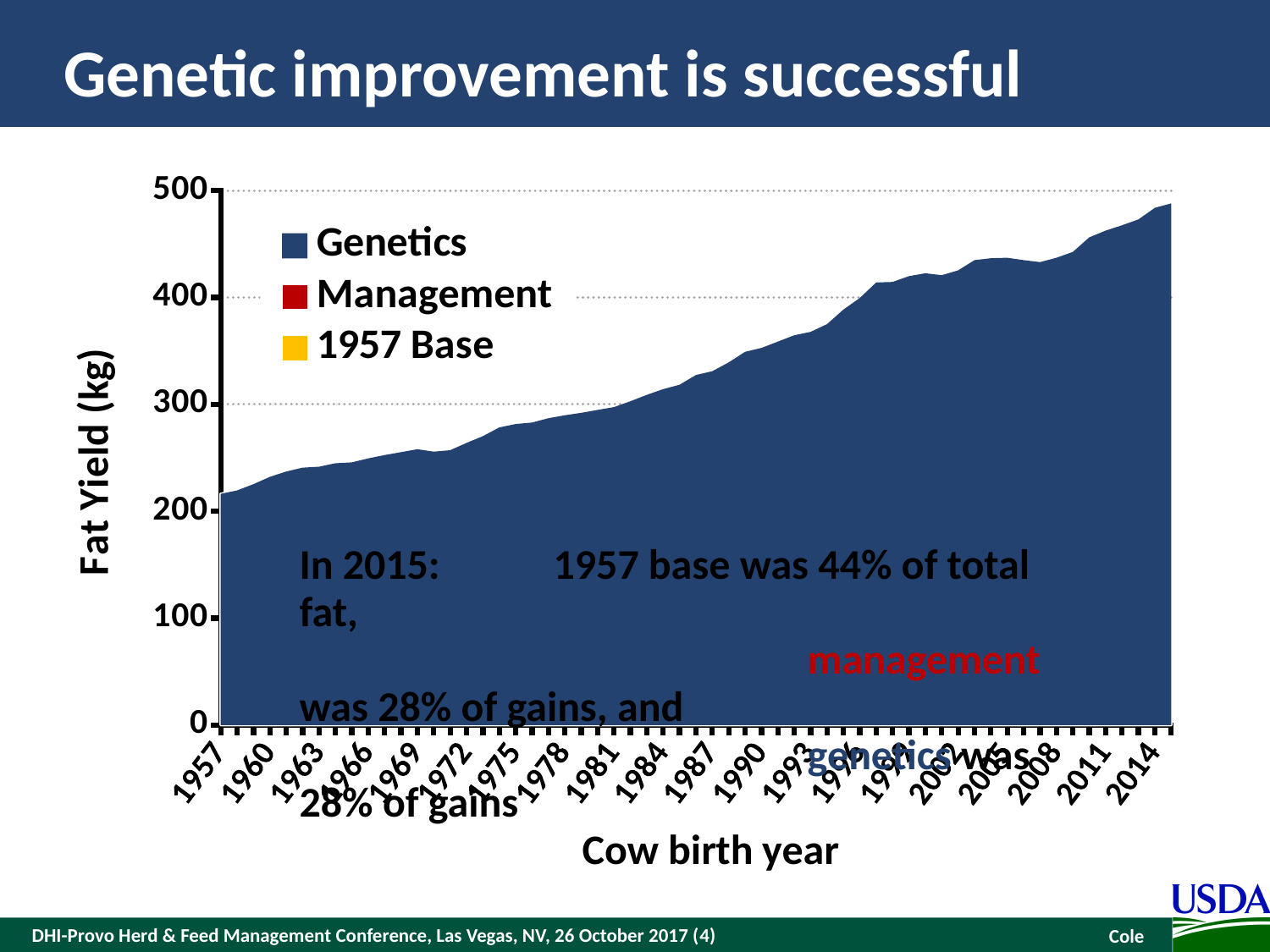
What kind of chart is shown on the slide? area chart Is the fat yield for cows born in 2008 greater or less than 400? greater Which cow birth year has the highest fat yield, 1957 or 2014? 2014 Does fat yield rise or fall as cow birth year increases from 1957 to 2014? rise Is the fat yield for cows born in 1972 greater or less than 300? less Is the fat yield for cows born in 1957 greater or less than 200? greater Which legend entry is shown in red? Management How many series does the chart legend list? 3 What is the title of the chart's vertical axis? Fat Yield (kg)